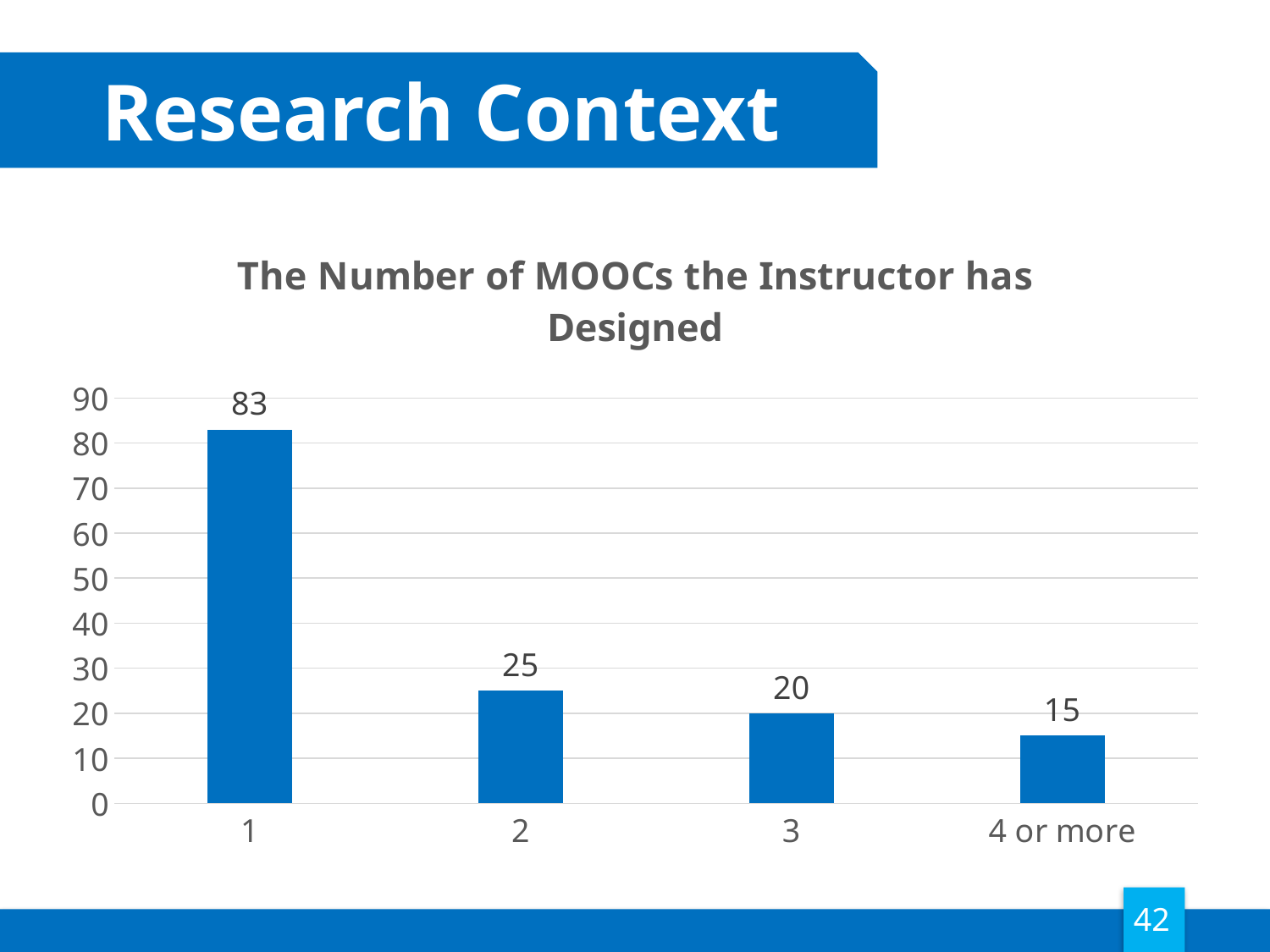
What is the value for the category "4 or more"? 15 Which is larger, the value for "2" or the value for "3"? 2 Is the value for "1" greater or less than 80? greater Which category has the lowest value? 4 or more What is the title of the chart? The Number of MOOCs the Instructor has Designed How many categories are shown on the x axis? 4 What is the value for the category "1"? 83 What kind of chart is shown on the slide? bar chart Which category has the highest value? 1 What is the difference between the values for "1" and "2"? 58 What is the difference between the values for "3" and "4 or more"? 5 What is the value for the category "3"? 20